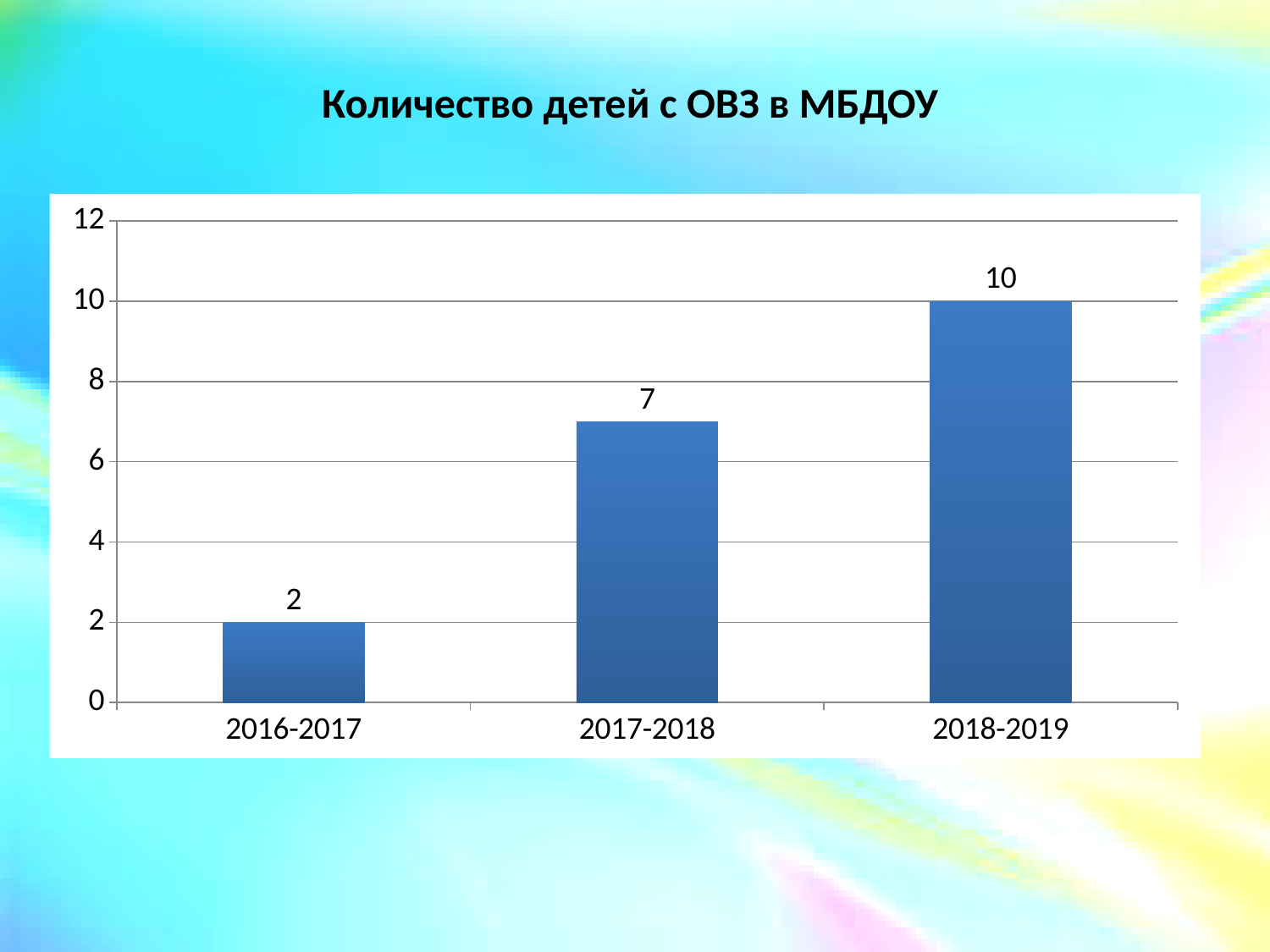
Do the values rise or fall from 2016-2017 to 2018-2019? rise What is the difference between the values for 2017-2018 and 2016-2017? 5 Which category has the highest value? 2018-2019 How many categories are shown on the x axis? 3 What is the value for 2017-2018? 7 Which category has the lowest value? 2016-2017 Which is larger, the value for 2017-2018 or the value for 2018-2019? 2018-2019 What is the value for 2018-2019? 10 What is the value for 2016-2017? 2 Is the value for 2017-2018 greater or less than 6? greater What is the difference between the values for 2018-2019 and 2016-2017? 8 What kind of chart is shown on the slide? bar chart